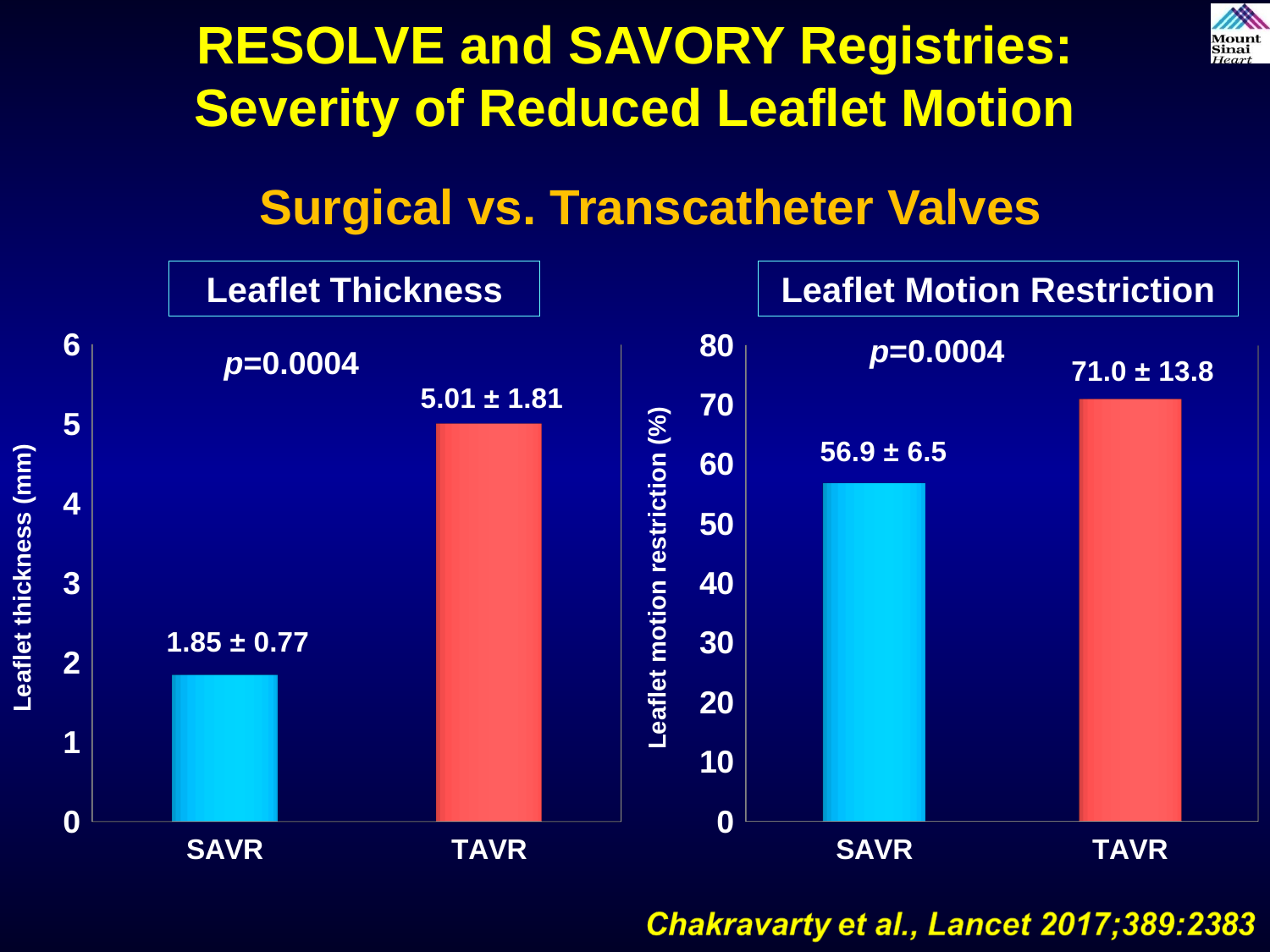
In the Leaflet Motion Restriction chart, what is the difference between the mean values for TAVR and SAVR? 14.1 In the Leaflet Thickness chart, what is the difference between the mean values for TAVR and SAVR? 3.16 In the Leaflet Thickness chart, which category has the higher value? TAVR In the Leaflet Thickness chart, what is the value shown for TAVR? 5.01 ± 1.81 What type of chart is the Leaflet Motion Restriction chart? Bar chart In the Leaflet Motion Restriction chart, what is the value shown for TAVR? 71.0 ± 13.8 In the Leaflet Motion Restriction chart, what is the value shown for SAVR? 56.9 ± 6.5 How many categories are shown in the Leaflet Thickness chart? 2 In the Leaflet Motion Restriction chart, which category has the lower value? SAVR In the Leaflet Motion Restriction chart, is the value for SAVR greater or less than 50? greater In the Leaflet Thickness chart, what is the value shown for SAVR? 1.85 ± 0.77 What is the y-axis label of the Leaflet Thickness chart? Leaflet thickness (mm)